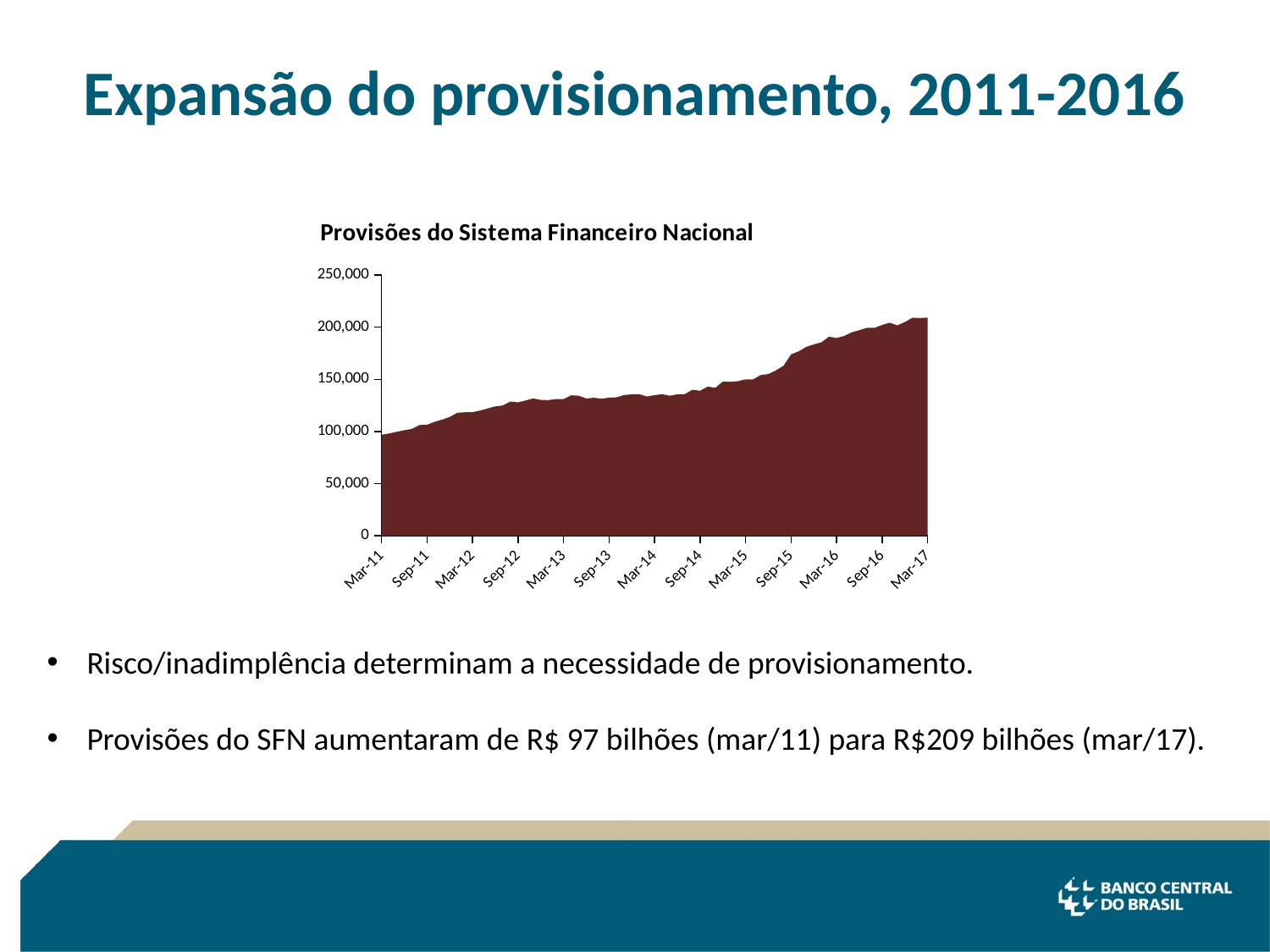
How many date labels are shown on the x axis of the chart? 13 Is the value for Sep-15 greater or less than 150,000? greater Is the value for Mar-13 greater or less than 150,000? less What is the highest value shown on the y axis of the chart? 250,000 At which x-axis label is the plotted value highest? Mar-17 Is the value for Mar-11 greater or less than 100,000? less What kind of chart is shown on the slide? Area chart At which x-axis label is the plotted value lowest? Mar-11 What is the title of the chart? Provisões do Sistema Financeiro Nacional Which is larger, the value for Mar-16 or the value for Mar-12? Mar-16 Do the values in the chart generally rise or fall from Mar-11 to Mar-17? Rise